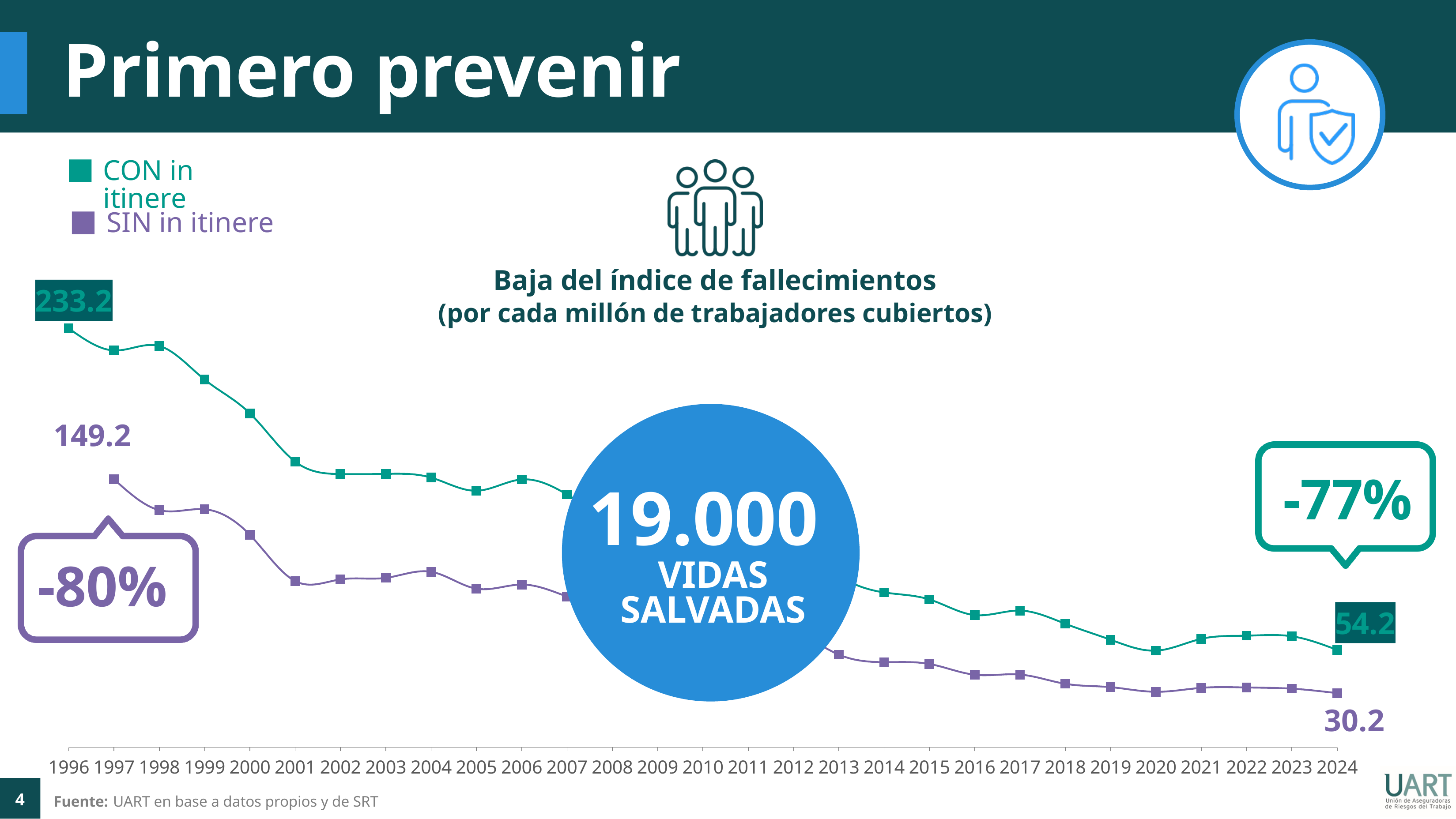
In 2024, which series has the higher value, CON in itinere or SIN in itinere? CON in itinere What is the first labelled value of the SIN in itinere series? 149.2 What kind of chart is shown on the slide? line chart Do the values of the CON in itinere series generally rise or fall from 1996 to 2024? fall How many years are labelled on the x axis? 29 How many series does the legend list? 2 What is the value of the CON in itinere series in 2024? 54.2 By how much did the CON in itinere value fall from 1996 to 2024? 179.0 What is the value of the CON in itinere series in 1996? 233.2 What is the difference between the CON in itinere and SIN in itinere values in 2024? 24.0 What is the value of the SIN in itinere series in 2024? 30.2 What percentage change is shown in the callout for the SIN in itinere series? -80%